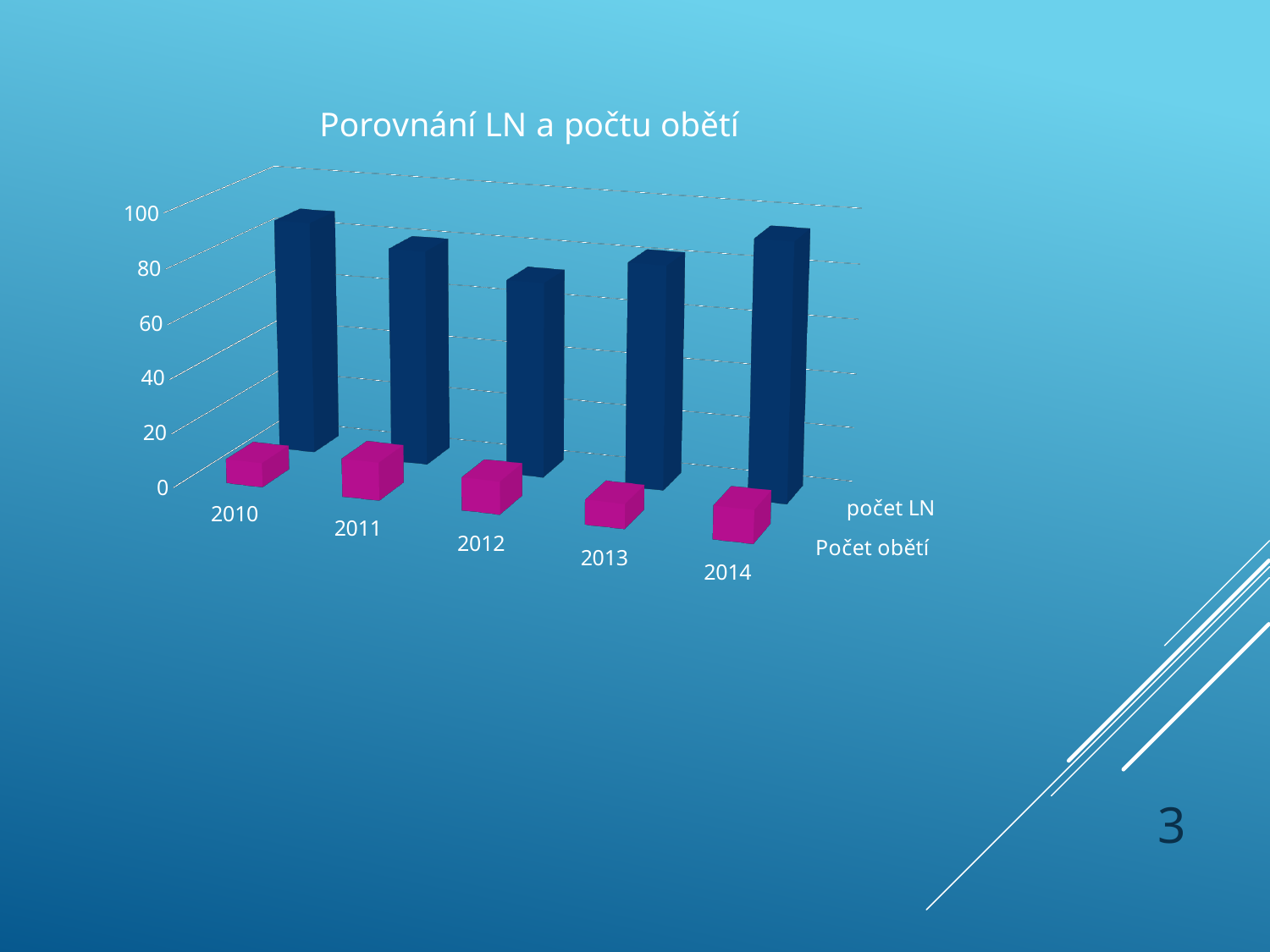
What kind of chart is shown on the slide? bar chart How many years are shown on the x axis? 5 Is the value for počet LN in 2012 greater or less than 60? greater What is the title of the chart? Porovnání LN a počtu obětí Which year has the highest value for počet LN? 2014 Which colour represents the Počet obětí series? magenta Do the values for počet LN rise or fall from 2010 to 2012? fall Is the value for Počet obětí in 2010 greater or less than 40? less Is the value for počet LN in 2010 greater or less than 80? greater In 2014, which series has the larger value, počet LN or Počet obětí? počet LN Which is larger, počet LN in 2010 or počet LN in 2012? počet LN in 2010